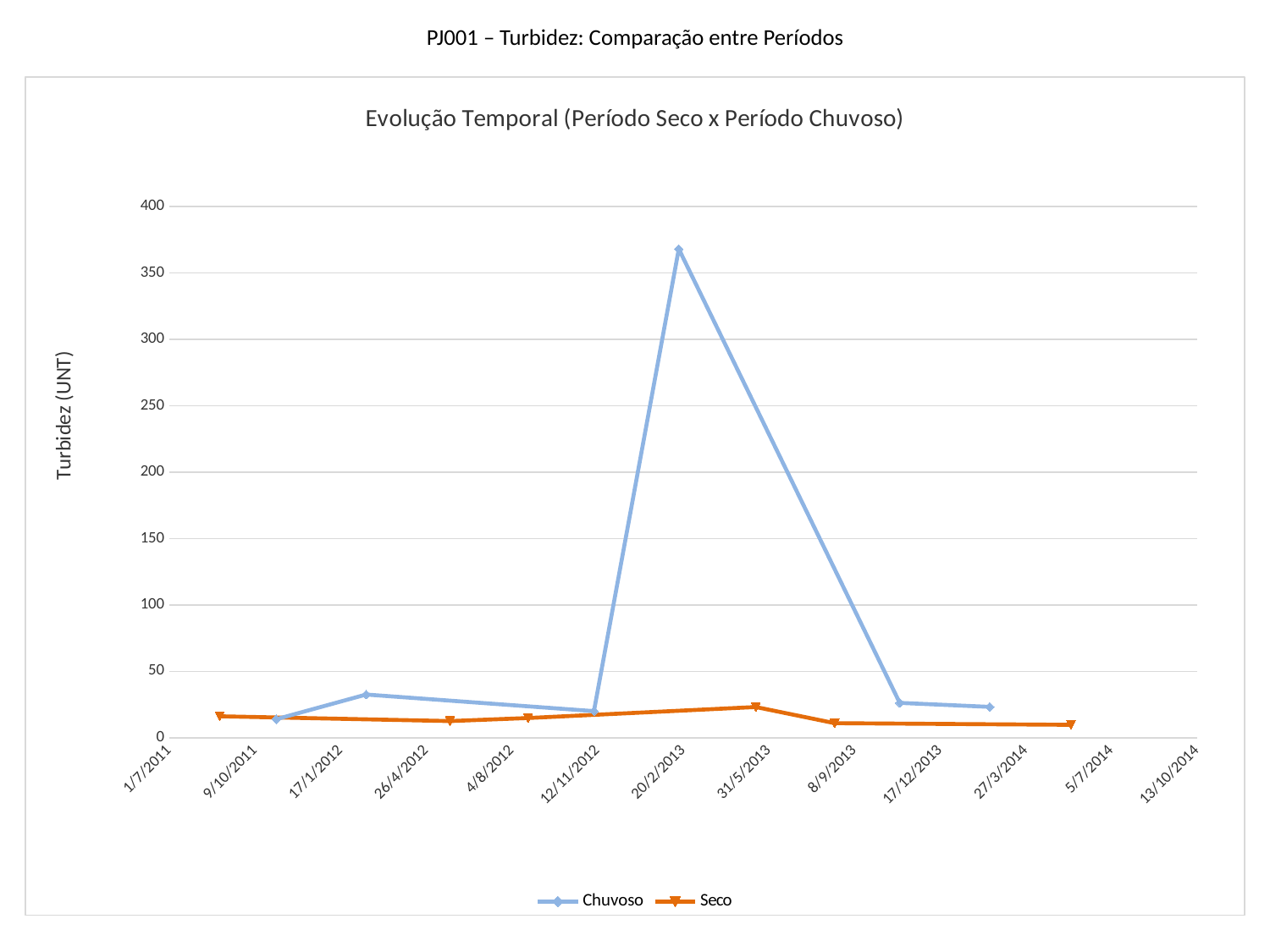
Which series has the higher maximum value, Chuvoso or Seco? Chuvoso Is the peak value of the Chuvoso series greater or less than 400? less How many date labels are shown along the x axis? 13 After reaching its peak near 20/2/2013, does the Chuvoso line rise or fall? fall What is the label of the vertical axis? Turbidez (UNT) What kind of chart is shown on the slide? line chart Is the peak value of the Chuvoso series greater or less than 300? greater How many series does the legend list? 2 Which series reaches the highest value on the chart? Chuvoso Is the highest value of the Seco series greater or less than 50? less What are the two series named in the legend? Chuvoso and Seco